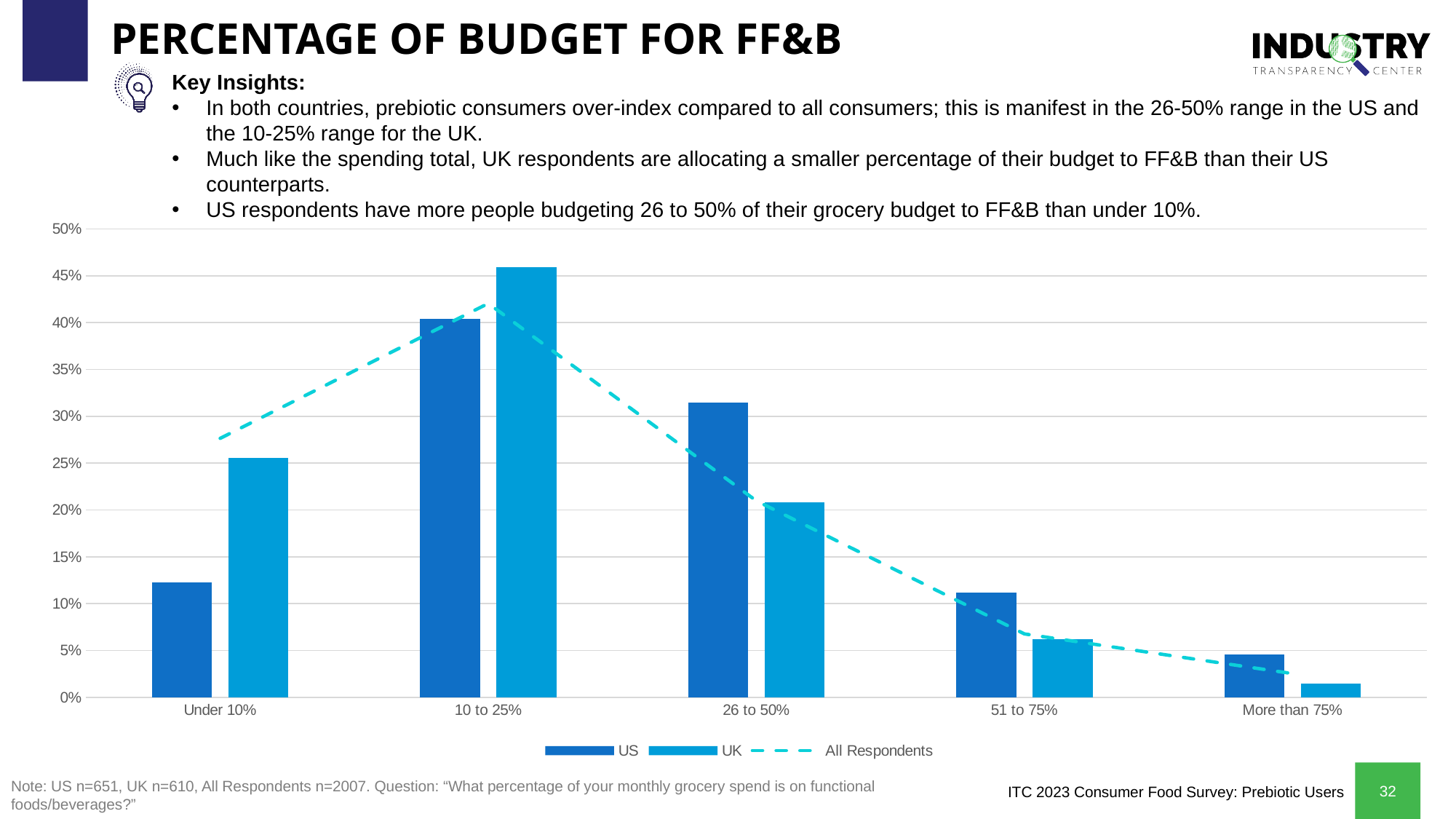
How many budget-range categories are shown on the x axis? 5 Do the UK bars rise or fall moving from 10 to 25% through to More than 75%? fall Is the UK value for More than 75% greater or less than 5%? less Which category has the lowest US bar? More than 75% Which category has the highest US bar? 10 to 25% How many series does the legend list? 3 Is the UK value for 10 to 25% greater or less than 40%? greater What kind of chart is shown on the slide? combination bar and line chart Which category has the highest UK bar? 10 to 25% In the 26 to 50% category, which is larger, the US bar or the UK bar? US In the Under 10% category, which is larger, the US bar or the UK bar? UK Is the US value for 10 to 25% greater or less than 35%? greater